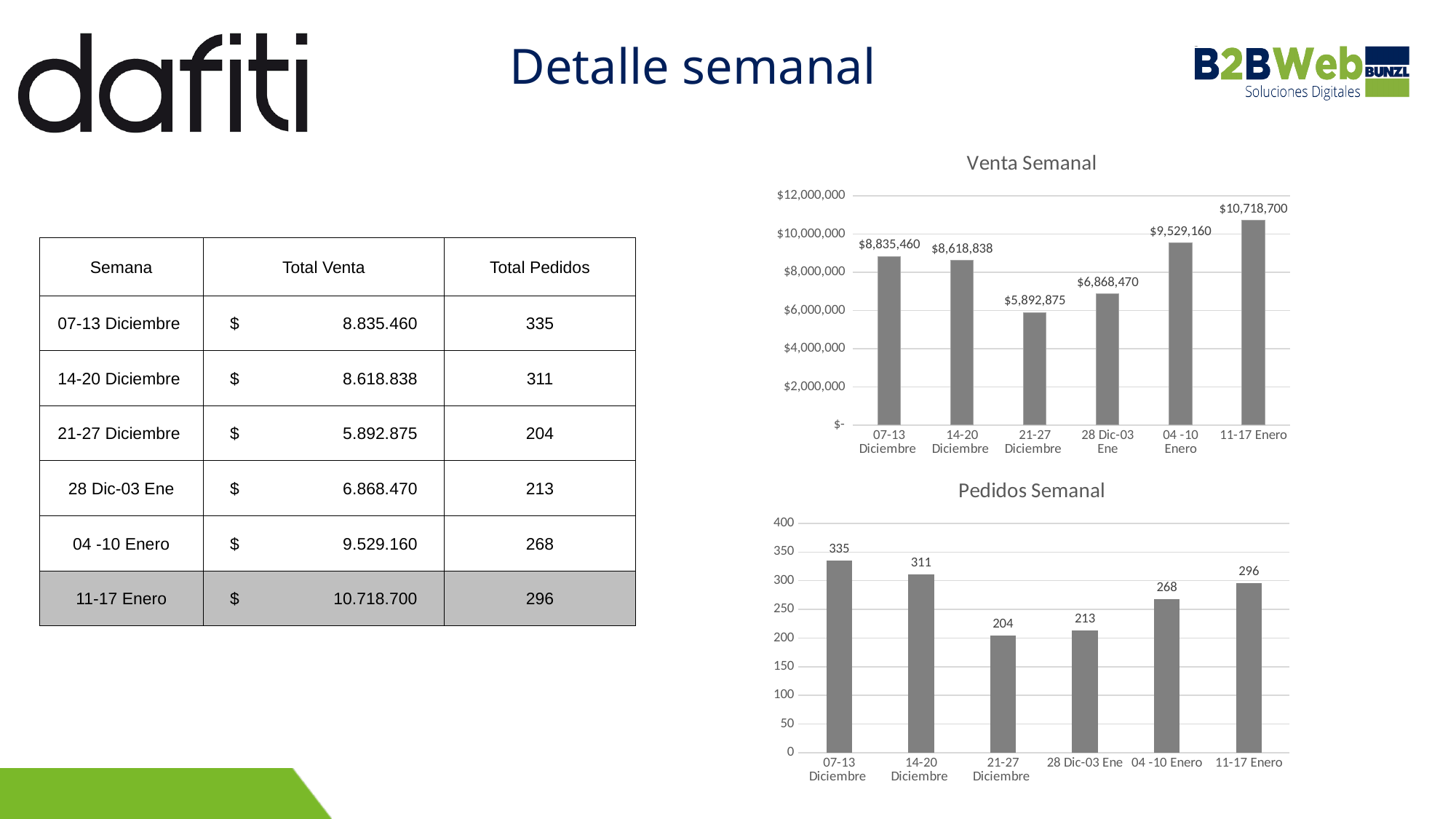
In the Pedidos Semanal chart, what is the difference between the values for 07-13 Diciembre and 14-20 Diciembre? 24 What kind of chart is the Venta Semanal chart? bar chart In the Pedidos Semanal chart, which week has the highest value? 07-13 Diciembre In the Venta Semanal chart, which week has the lowest value? 21-27 Diciembre In the Pedidos Semanal chart, which week has the lowest value? 21-27 Diciembre In the Venta Semanal chart, which week has the highest value? 11-17 Enero In the Pedidos Semanal chart, what is the value for 04 -10 Enero? 268 In the Venta Semanal chart, what is the value for 21-27 Diciembre? $5,892,875 In the Pedidos Semanal chart, which is larger, the value for 28 Dic-03 Ene or the value for 11-17 Enero? 11-17 Enero In the Venta Semanal chart, what is the difference between the values for 11-17 Enero and 04 -10 Enero? $1,189,540 How many weeks are shown in the Pedidos Semanal chart? 6 In the Venta Semanal chart, is the value for 28 Dic-03 Ene greater or less than $8,000,000? less